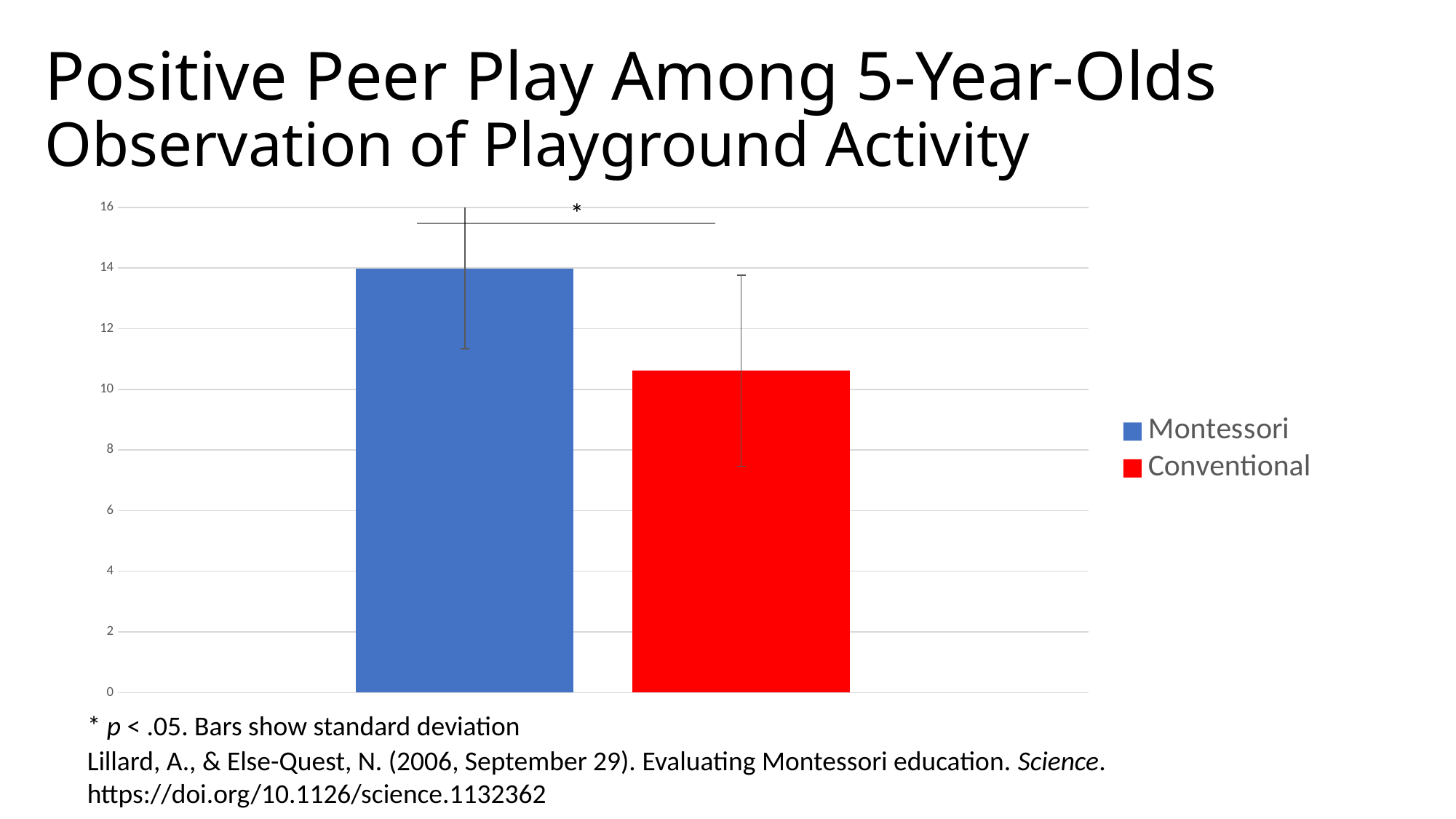
How many series does the legend list? 2 Which group has the higher bar, Montessori or Conventional? Montessori According to the footnote, what do the error bars on the chart show? standard deviation What colour is the bar for Conventional? red Is the value for Montessori greater or less than 12? greater Is the value for Montessori greater or less than 16? less Is the value for Conventional greater or less than 10? greater How many bars are plotted in the chart? 2 What kind of chart is shown on the slide? bar chart Which group has the highest value in the chart? Montessori Which group has the lowest value in the chart? Conventional